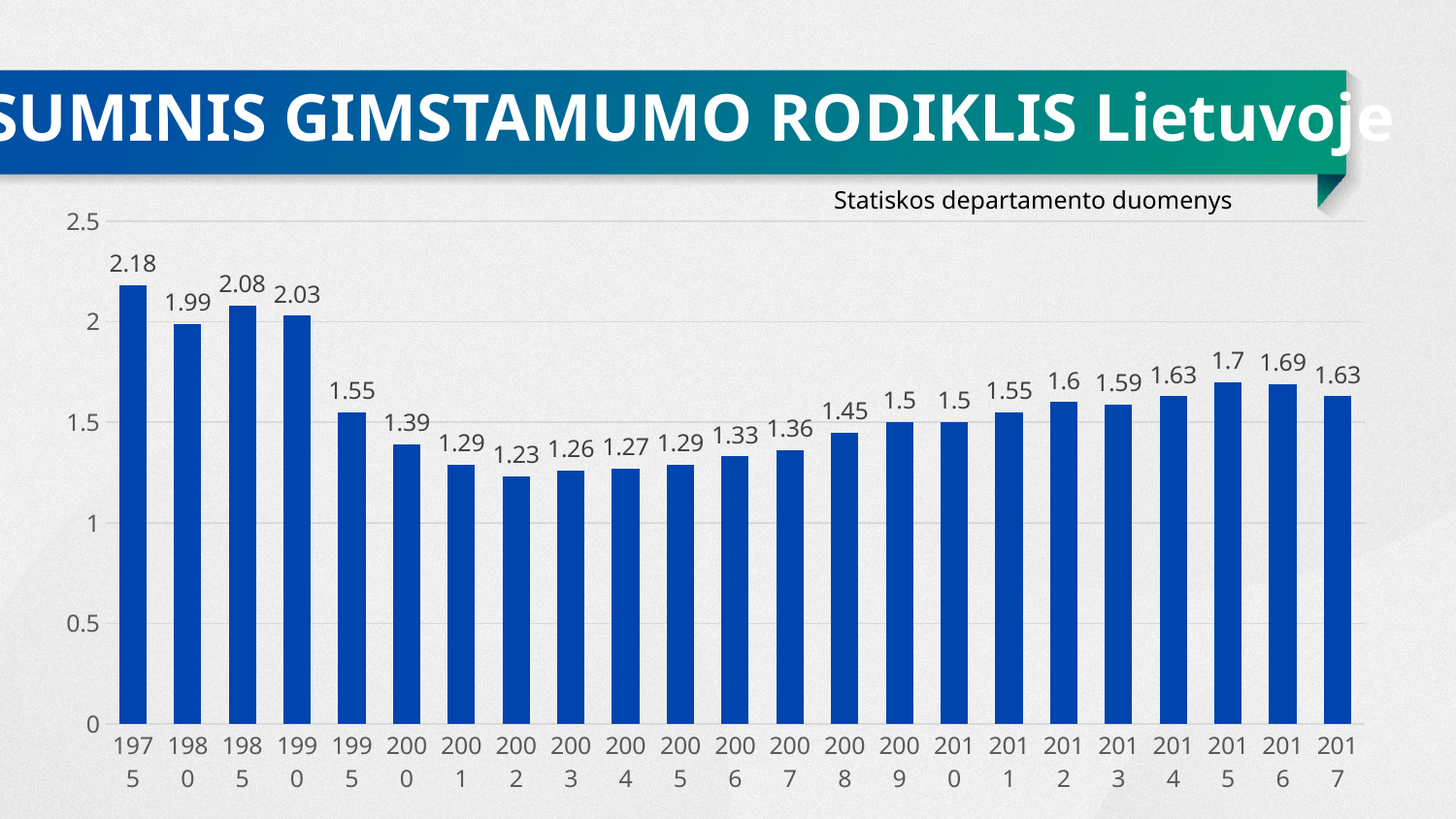
What is the title of the chart? SUMINIS GIMSTAMUMO RODIKLIS Lietuvoje What is the value for 2017? 1.63 Do the values rise or fall from 2002 to 2015? rise What kind of chart is shown on the slide? bar chart What is the value for 1975? 2.18 What is the difference between the values for 1975 and 2017? 0.55 How many bars are shown in the chart? 23 Which is larger, the value for 1985 or the value for 1990? 1985 What is the value for 2002? 1.23 Is the value for 1995 greater or less than 2? less Which year has the highest value? 1975 Which year has the lowest value? 2002